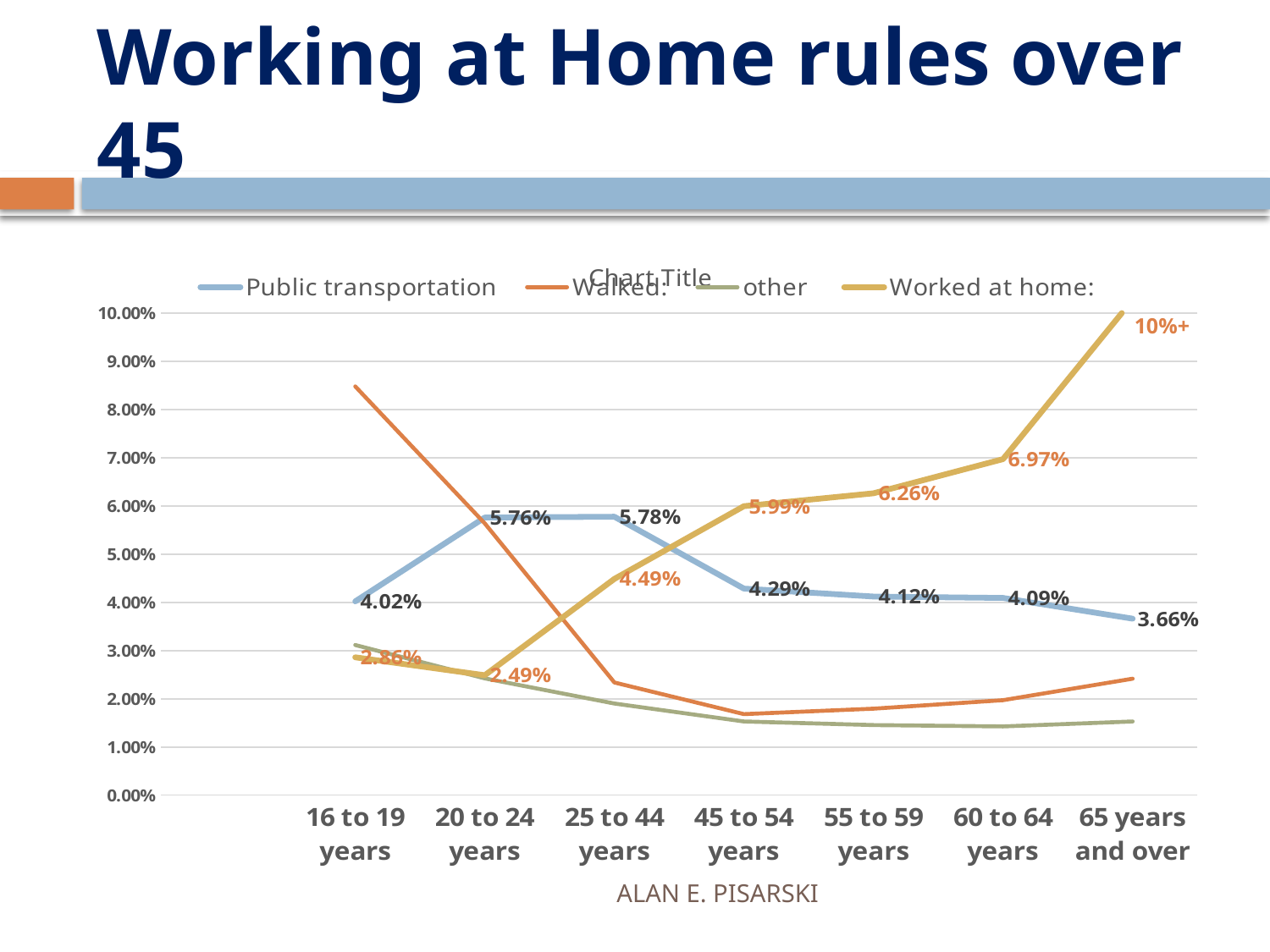
Is the Walked value for 16 to 19 years greater or less than 8.00%? greater What is the difference between the Public transportation values for 25 to 44 years and 65 years and over? 2.12% Which age group has the lowest Worked at home value? 20 to 24 years Does the Worked at home series rise or fall from 25 to 44 years to 65 years and over? Rise What is the Public transportation value for 16 to 19 years? 4.02% Which age group has the highest Public transportation value? 25 to 44 years What kind of chart is shown on the slide? Line chart How many age-group categories are shown on the x axis? 7 For 55 to 59 years, which is larger: Worked at home or Public transportation? Worked at home What is the Worked at home value for 60 to 64 years? 6.97% How many series does the legend list? 4 What is the Worked at home value for 45 to 54 years? 5.99%